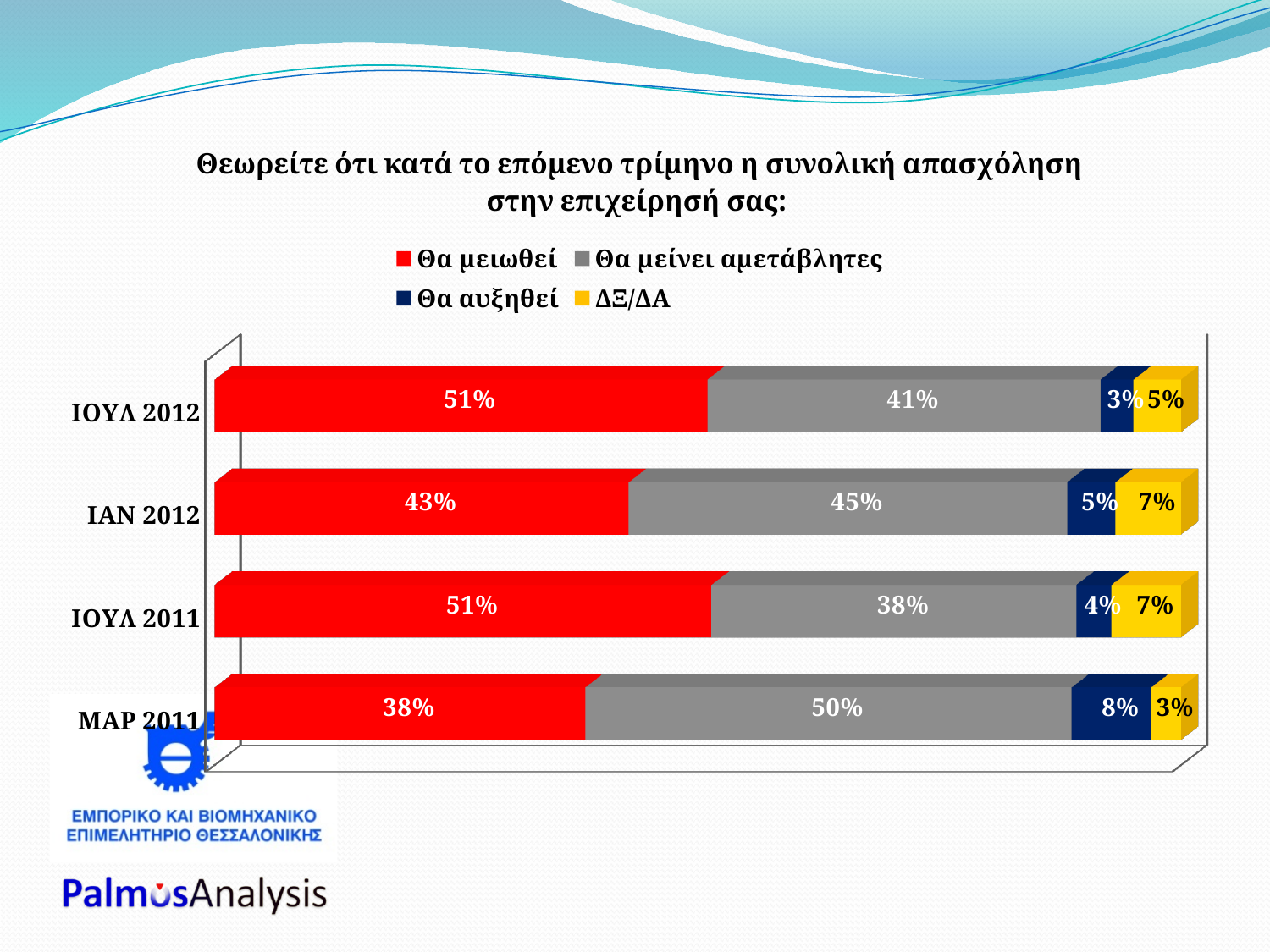
Which colour represents "ΔΞ/ΔΑ" in the chart? Yellow In which period was the share of "Θα αυξηθεί" highest? ΜΑΡ 2011 Which is larger in ΙΑΝ 2012: "Θα μειωθεί" or "Θα μείνει αμετάβλητες"? Θα μείνει αμετάβλητες How many time periods are shown on the chart? 4 What percentage of respondents in ΙΟΥΛ 2012 answered "Θα μειωθεί"? 51% How many series does the legend list? 4 What is the value for "Θα αυξηθεί" in ΙΑΝ 2012? 5% What type of chart is shown on the slide? Stacked bar chart What is the value for "ΔΞ/ΔΑ" in ΙΟΥΛ 2011? 7% What is the difference between the "Θα μειωθεί" values for ΙΟΥΛ 2012 and ΙΑΝ 2012? 8% What is the value for "Θα μείνει αμετάβλητες" in ΜΑΡ 2011? 50% In which period was the share of "Θα μειωθεί" lowest? ΜΑΡ 2011